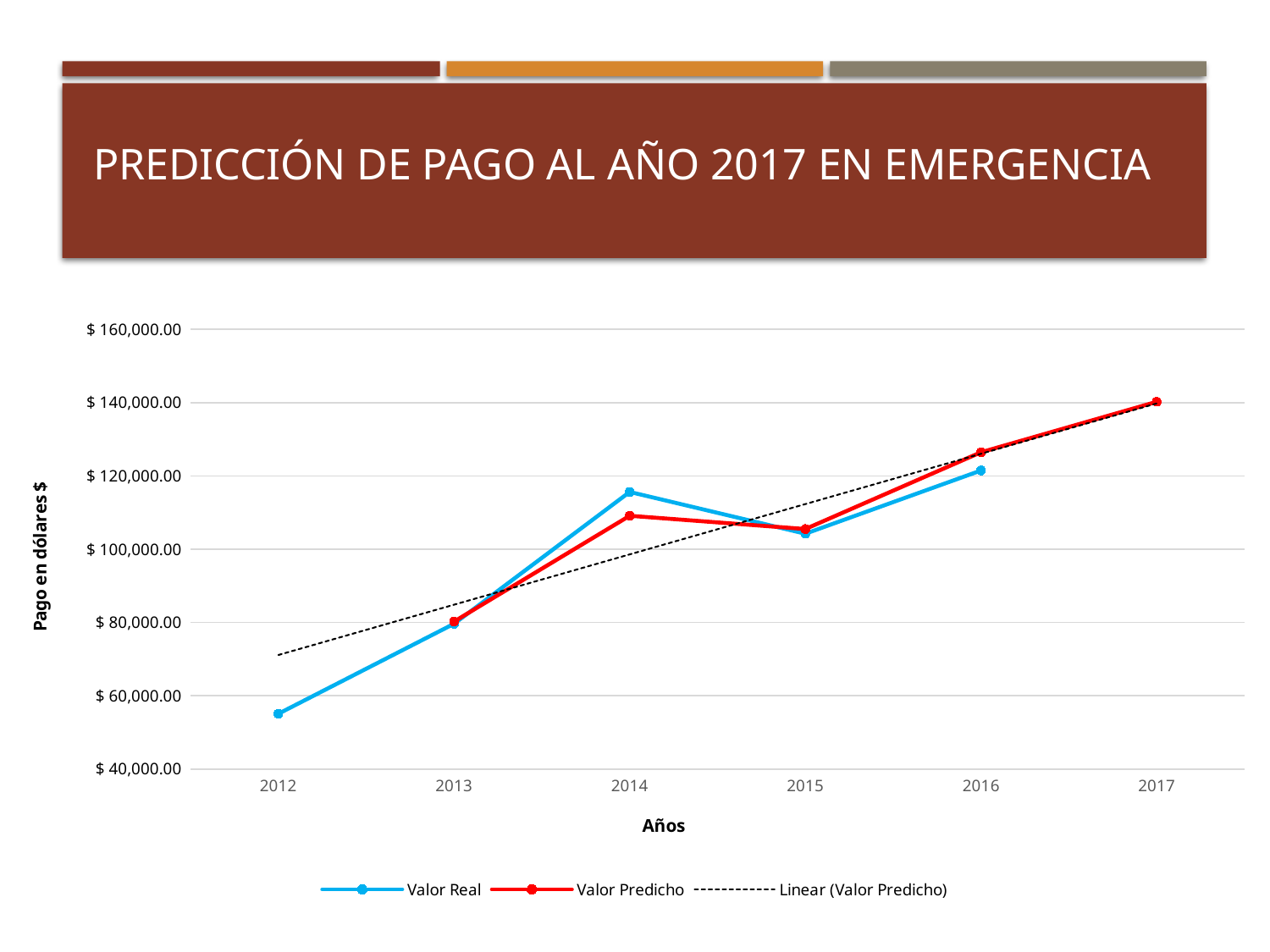
Is the Valor Real value for 2014 greater or less than $ 100,000.00? greater In 2014, which series has the larger value, Valor Real or Valor Predicho? Valor Real What is the label of the vertical axis of the chart? Pago en dólares $ How many entries does the chart legend list? 3 Does the Valor Real series rise or fall from 2014 to 2015? fall Is the Valor Predicho value for 2016 greater or less than $ 120,000.00? greater In which year is the Valor Real series at its lowest? 2012 How many years are shown on the x axis of the chart? 6 Is the Valor Predicho value for 2013 greater or less than $ 100,000.00? less What kind of chart is shown on the slide? line chart In which year is the Valor Predicho series at its highest? 2017